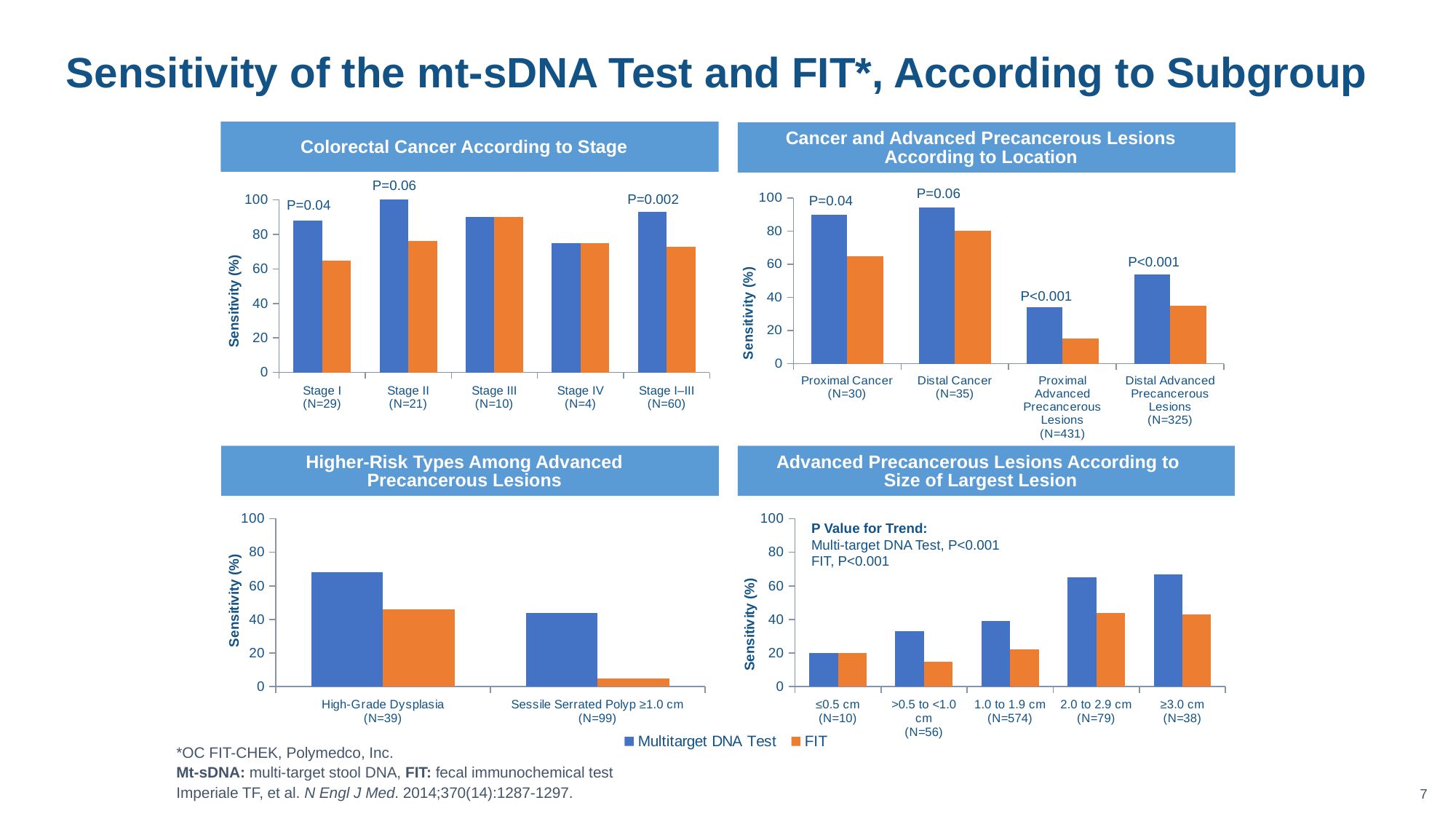
In the "Colorectal Cancer According to Stage" chart, what P value is printed above the Stage I–III (N=60) bars? P=0.002 In the "Higher-Risk Types Among Advanced Precancerous Lesions" chart, which is larger for High-Grade Dysplasia (N=39): the Multitarget DNA Test or FIT? Multitarget DNA Test In the "Advanced Precancerous Lesions According to Size of Largest Lesion" chart, how many size categories are shown? 5 In the "Colorectal Cancer According to Stage" chart, what is the Multitarget DNA Test sensitivity for Stage II (N=21)? 100 In the "Higher-Risk Types Among Advanced Precancerous Lesions" chart, which bar is the lowest? FIT for Sessile Serrated Polyp ≥1.0 cm (N=99) In the "Colorectal Cancer According to Stage" chart, is the FIT value for Stage I (N=29) greater or less than 80? less In the "Advanced Precancerous Lesions According to Size of Largest Lesion" chart, do the Multitarget DNA Test values rise or fall as lesion size increases along the x axis? rise How many series does the legend at the bottom of the slide list? 2 What kind of chart is the "Colorectal Cancer According to Stage" chart? bar chart In the "Cancer and Advanced Precancerous Lesions According to Location" chart, which category has the lowest FIT sensitivity? Proximal Advanced Precancerous Lesions (N=431) In the "Colorectal Cancer According to Stage" chart, how many stage categories are shown on the x axis? 5 In the "Cancer and Advanced Precancerous Lesions According to Location" chart, is the Multitarget DNA Test value for Proximal Advanced Precancerous Lesions (N=431) greater or less than 40? less